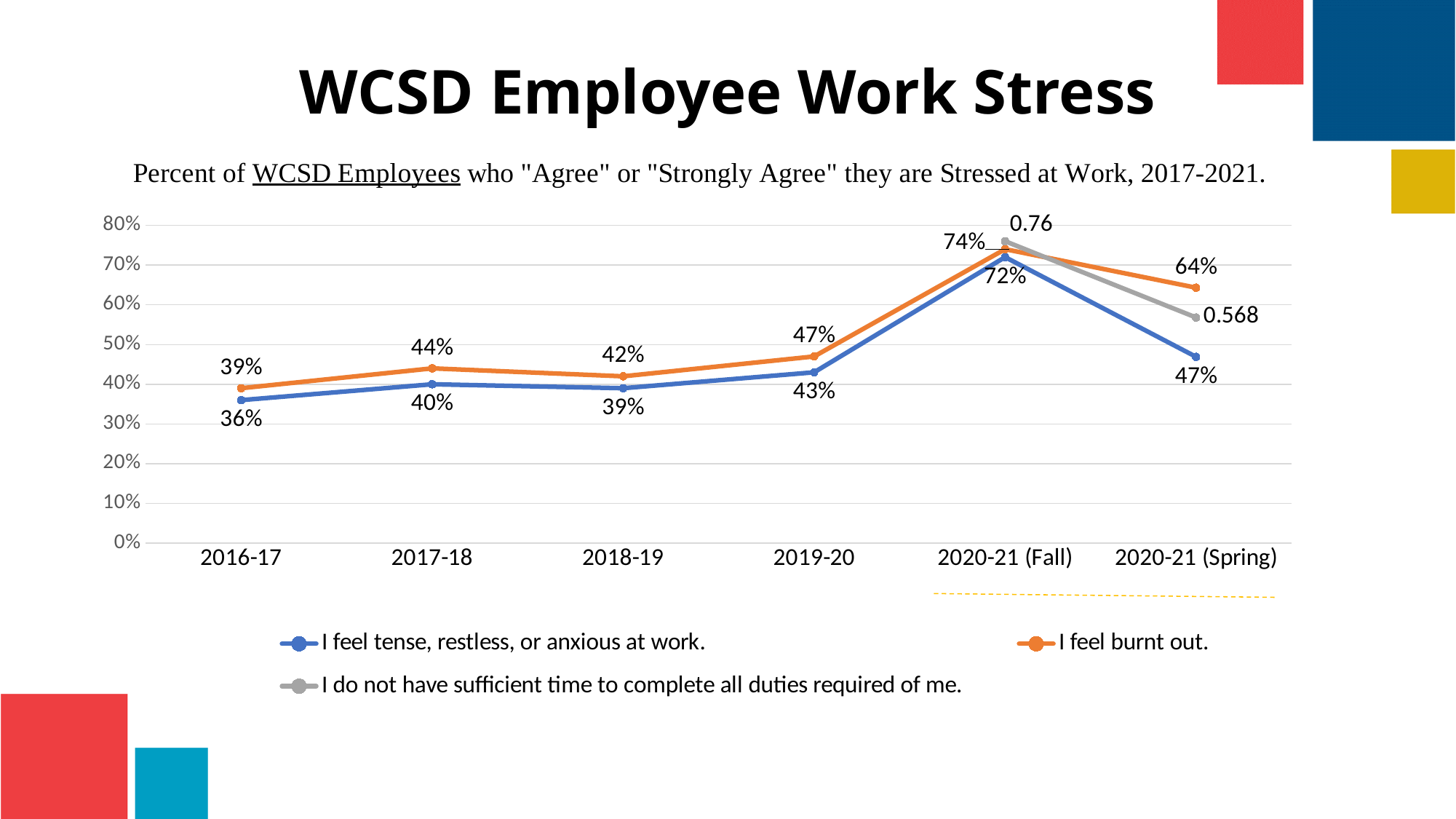
Does "I feel tense, restless, or anxious at work." rise or fall from 2020-21 (Fall) to 2020-21 (Spring)? fall How many series does the legend list? 3 What kind of chart is shown on the slide? line chart In which period is "I feel tense, restless, or anxious at work." highest? 2020-21 (Fall) How many time periods are shown on the x axis? 6 What colour is the line for "I feel burnt out."? orange What is the value for "I feel burnt out." in 2020-21 (Fall)? 74% What is the value for "I do not have sufficient time to complete all duties required of me." in 2020-21 (Spring)? 0.568 What is the difference between "I feel burnt out." and "I feel tense, restless, or anxious at work." in 2020-21 (Spring)? 17% What is the value for "I feel tense, restless, or anxious at work." in 2016-17? 36% Which is larger in 2019-20: "I feel burnt out." or "I feel tense, restless, or anxious at work."? I feel burnt out. In which period is "I feel burnt out." lowest? 2016-17